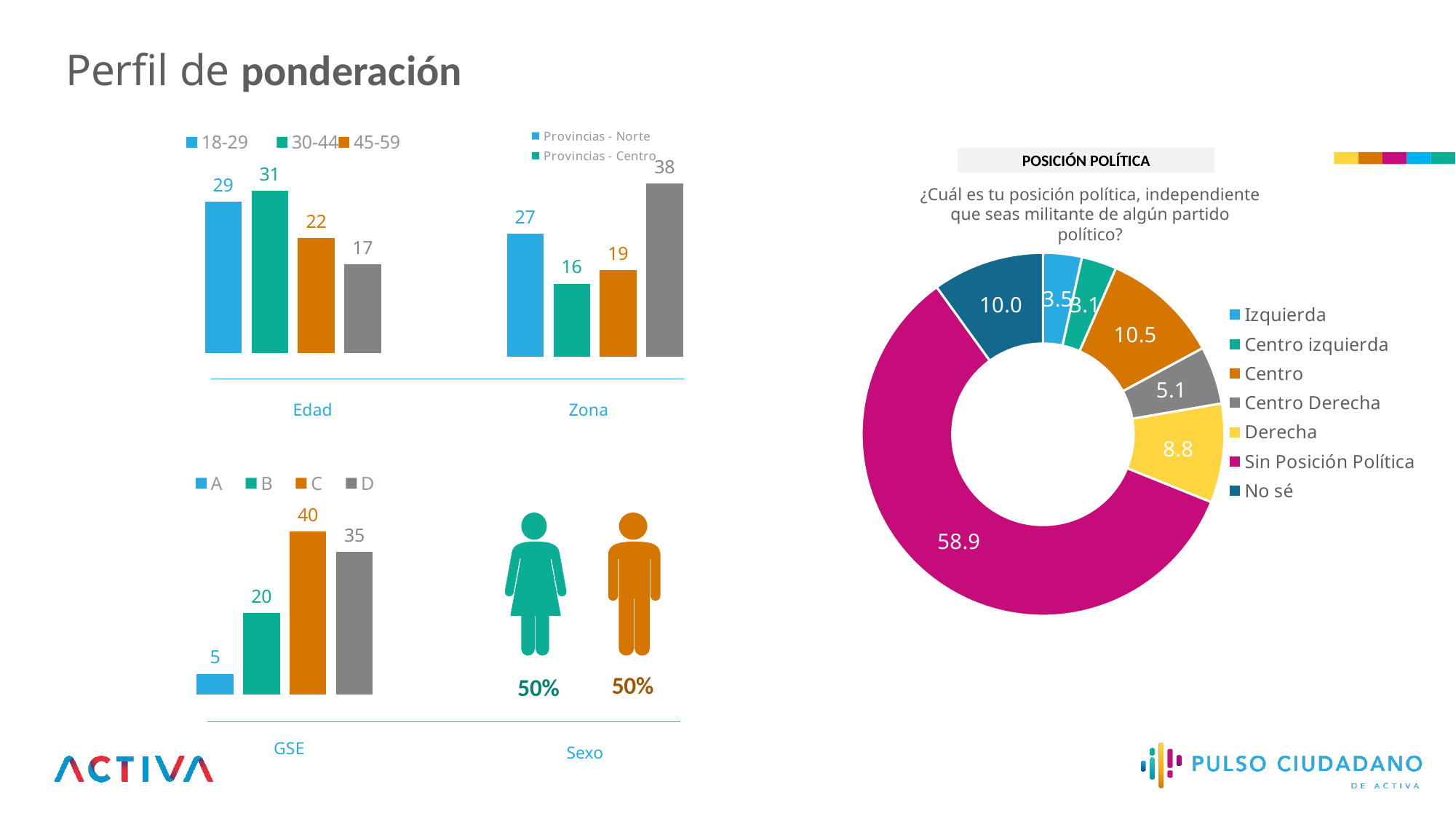
In the Edad bar chart, which labelled age group has the highest value? 30-44 In the Posición Política donut chart, which category has the smallest value? Centro izquierda How many categories does the legend of the Posición Política donut chart list? 7 In the GSE bar chart, which category has the lowest value? A In the GSE bar chart, what is the value for category C? 40 In the Edad bar chart, what is the value for the 30-44 age group? 31 In the Posición Política donut chart, what is the difference between the values for Centro and Centro Derecha? 5.4 In the Edad bar chart, what is the difference between the values for 18-29 and 45-59? 7 In the Posición Política donut chart, what is the value for Sin Posición Política? 58.9 In the Zona bar chart, what is the value for Provincias - Norte? 27 In the GSE bar chart, what is the difference between the values for C and D? 5 In the Zona bar chart, which is larger: Provincias - Norte or Provincias - Centro? Provincias - Norte